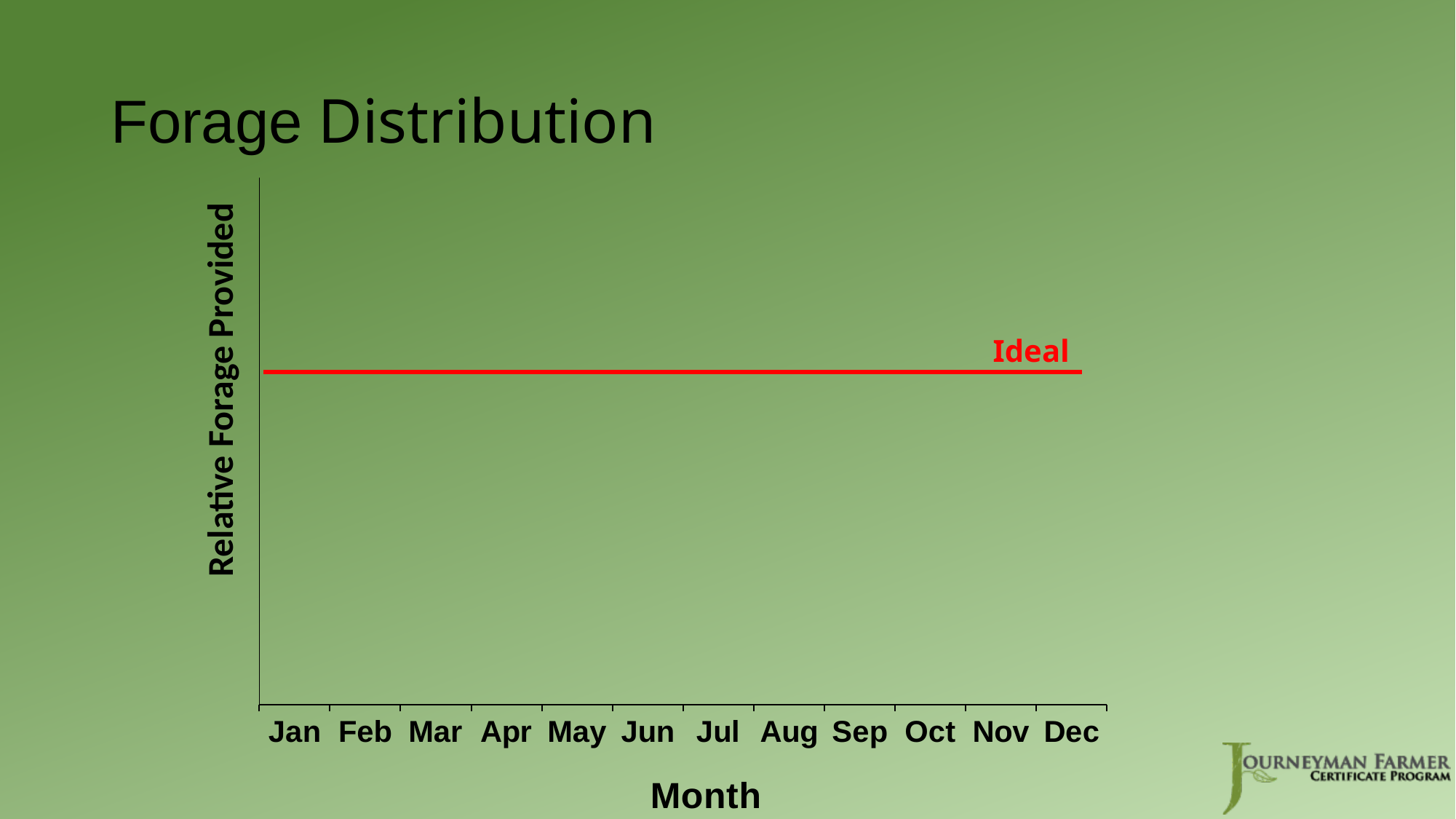
What is the x-axis title of the chart? Month How many lines are plotted on the chart? 1 How many months are labelled along the x axis of the chart? 12 What is the last month labelled on the x axis? Dec What is the first month labelled on the x axis? Jan What kind of chart is shown on the slide? line chart Does the 'Ideal' line rise, fall, or stay flat from Jan to Dec? stays flat